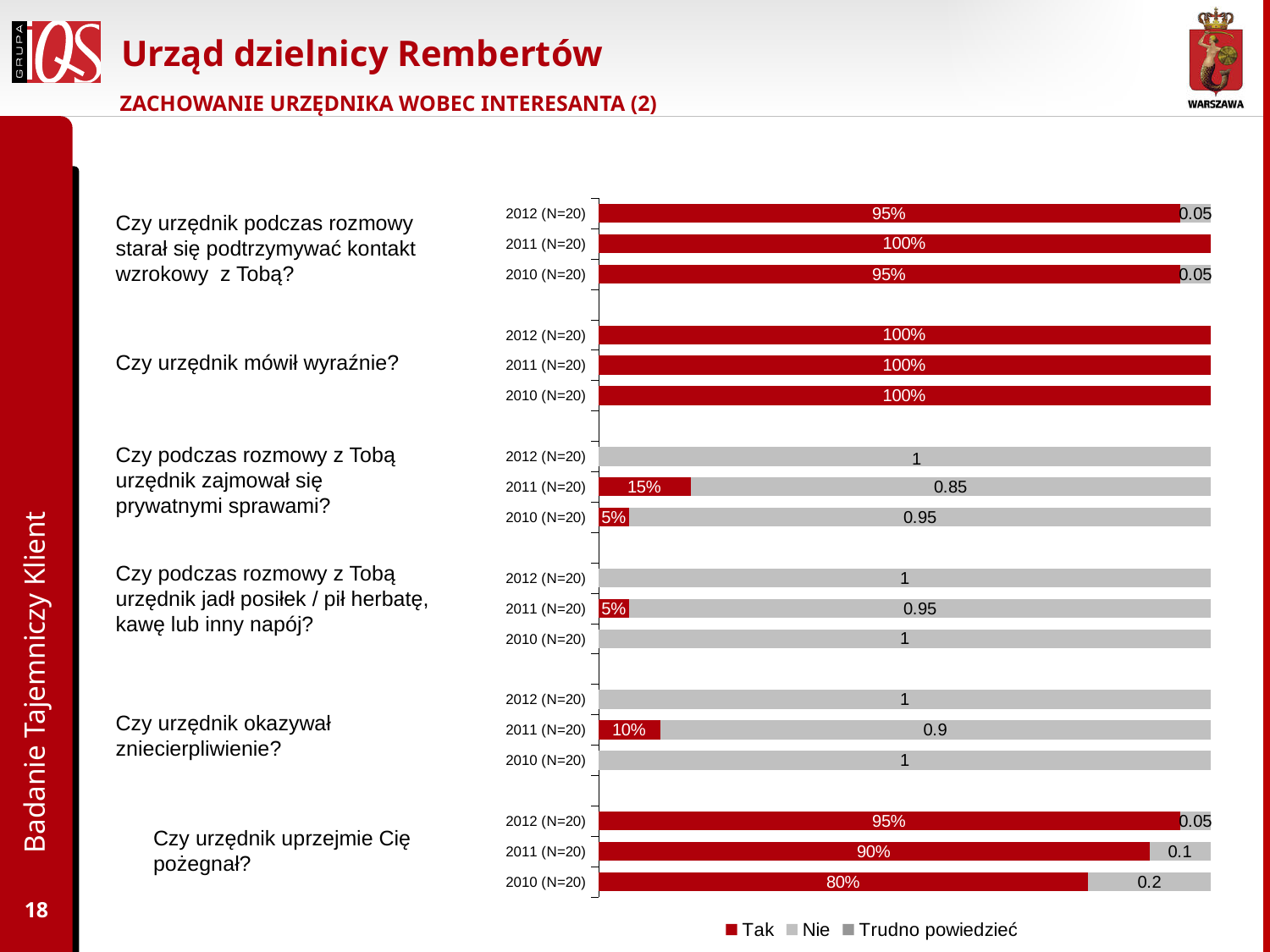
What are the legend entries of the chart? Tak, Nie, Trudno powiedzieć What is the 'Tak' value for 'Czy urzędnik uprzejmie Cię pożegnał?' in 2010 (N=20)? 80% For 'Czy urzędnik uprzejmie Cię pożegnał?', does the 'Tak' value rise or fall from 2010 to 2012? Rises Which has the larger 'Tak' value in 2011 (N=20): 'Czy urzędnik okazywał zniecierpliwienie?' or 'Czy podczas rozmowy z Tobą urzędnik jadł posiłek / pił herbatę, kawę lub inny napój?'? Czy urzędnik okazywał zniecierpliwienie? For 'Czy urzędnik podczas rozmowy starał się podtrzymywać kontakt wzrokowy z Tobą?', which year has the highest 'Tak' value? 2011 (N=20) How many series does the legend list? 3 What is the 'Nie' value for 'Czy urzędnik uprzejmie Cię pożegnał?' in 2011 (N=20)? 0.1 What is the 'Tak' value for 'Czy podczas rozmowy z Tobą urzędnik zajmował się prywatnymi sprawami?' in 2011 (N=20)? 15% What is the 'Tak' value for 'Czy urzędnik mówił wyraźnie?' in 2012 (N=20)? 100% What kind of chart is shown on the slide? Stacked bar chart What is the difference in the 'Tak' value for 'Czy urzędnik uprzejmie Cię pożegnał?' between 2012 and 2010? 15 percentage points What is the 'Nie' value for 'Czy urzędnik podczas rozmowy starał się podtrzymywać kontakt wzrokowy z Tobą?' in 2012 (N=20)? 0.05